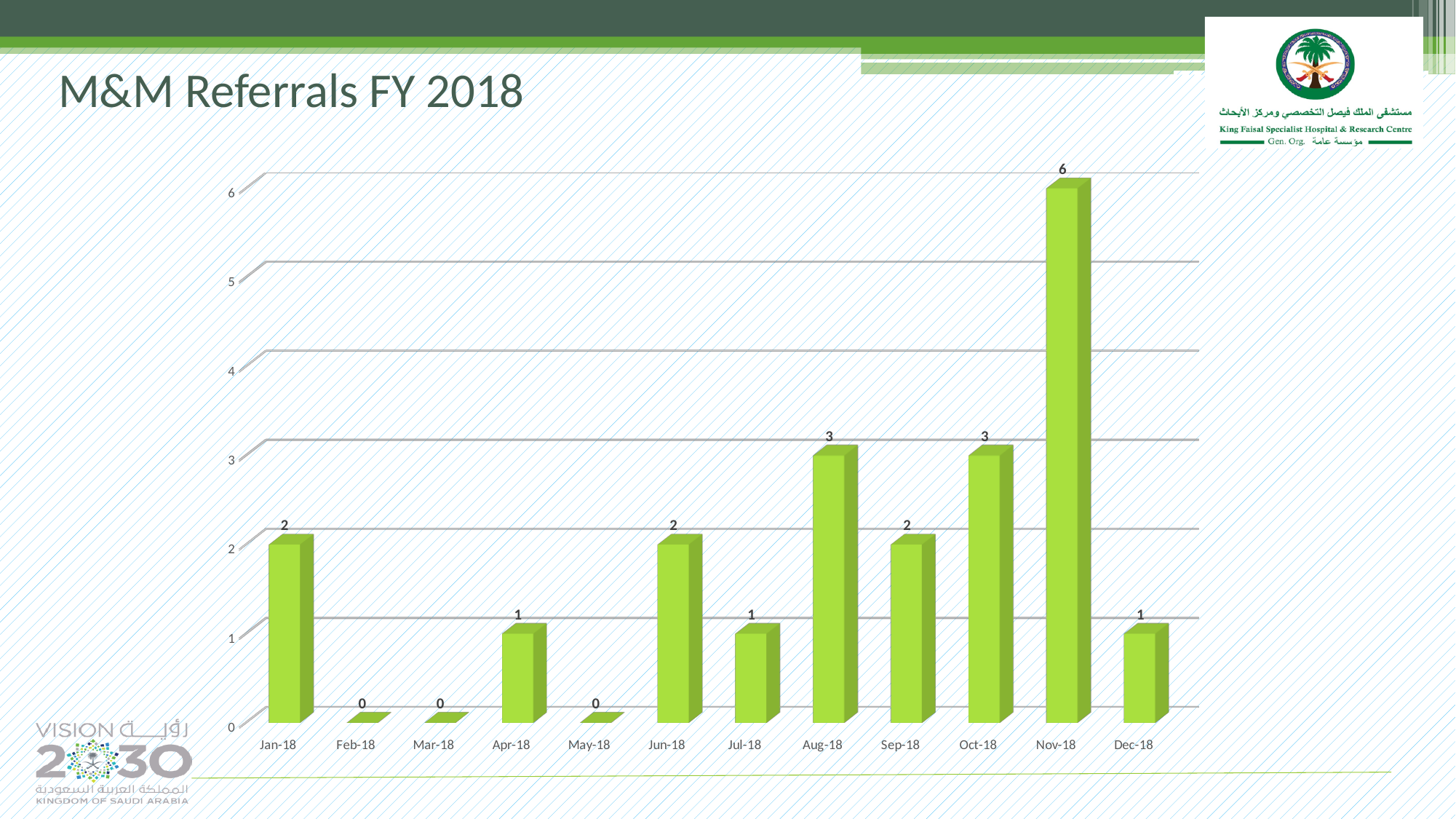
What is the title of the slide? M&M Referrals FY 2018 What kind of chart is shown on the slide? bar chart What is the value for Jan-18? 2 What is the total of the values for Jun-18, Jul-18 and Aug-18? 6 What is the value for Nov-18? 6 What is the value for Aug-18? 3 What is the difference between the values for Nov-18 and Oct-18? 3 How many months have a value of 0? 3 How many months are shown on the x axis? 12 Which month has the highest value? Nov-18 Which is larger, the value for Sep-18 or the value for Dec-18? Sep-18 What is the value for Apr-18? 1